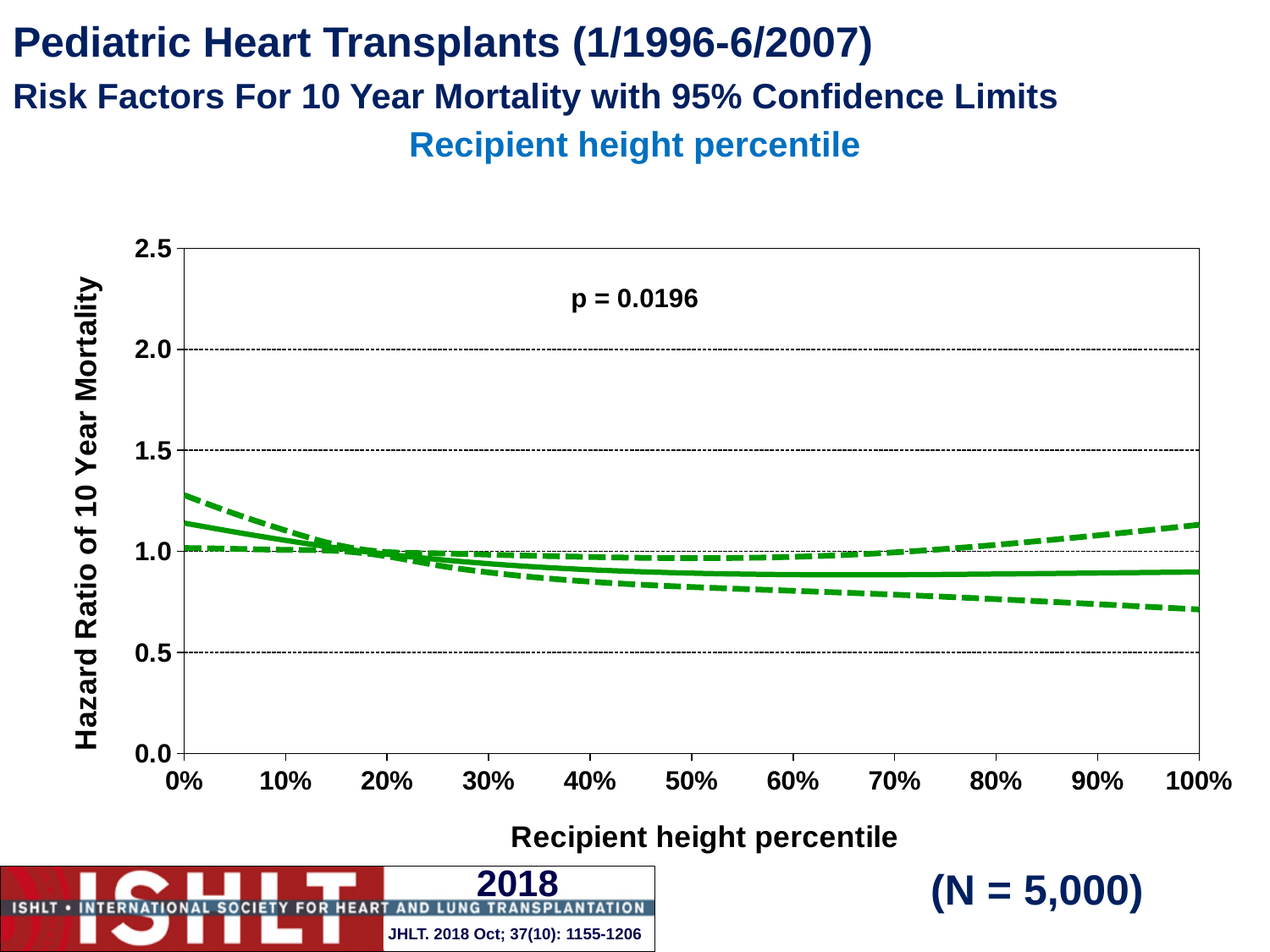
How many lines are plotted on the chart? 3 What is the highest value shown on the y axis? 2.5 What kind of chart is shown on the slide? line chart What is the p-value printed on the chart? p = 0.0196 Is the upper dashed confidence limit at a recipient height percentile of 100% greater or less than 1.0? greater What is the sample size (N) shown on the slide? N = 5,000 How many tick labels are shown on the x axis? 11 Is the solid line's hazard ratio at a recipient height percentile of 100% greater or less than 1.0? less Is the lower dashed confidence limit at a recipient height percentile of 100% greater or less than 1.0? less Does the solid hazard ratio line rise or fall between a recipient height percentile of 0% and 50%? fall